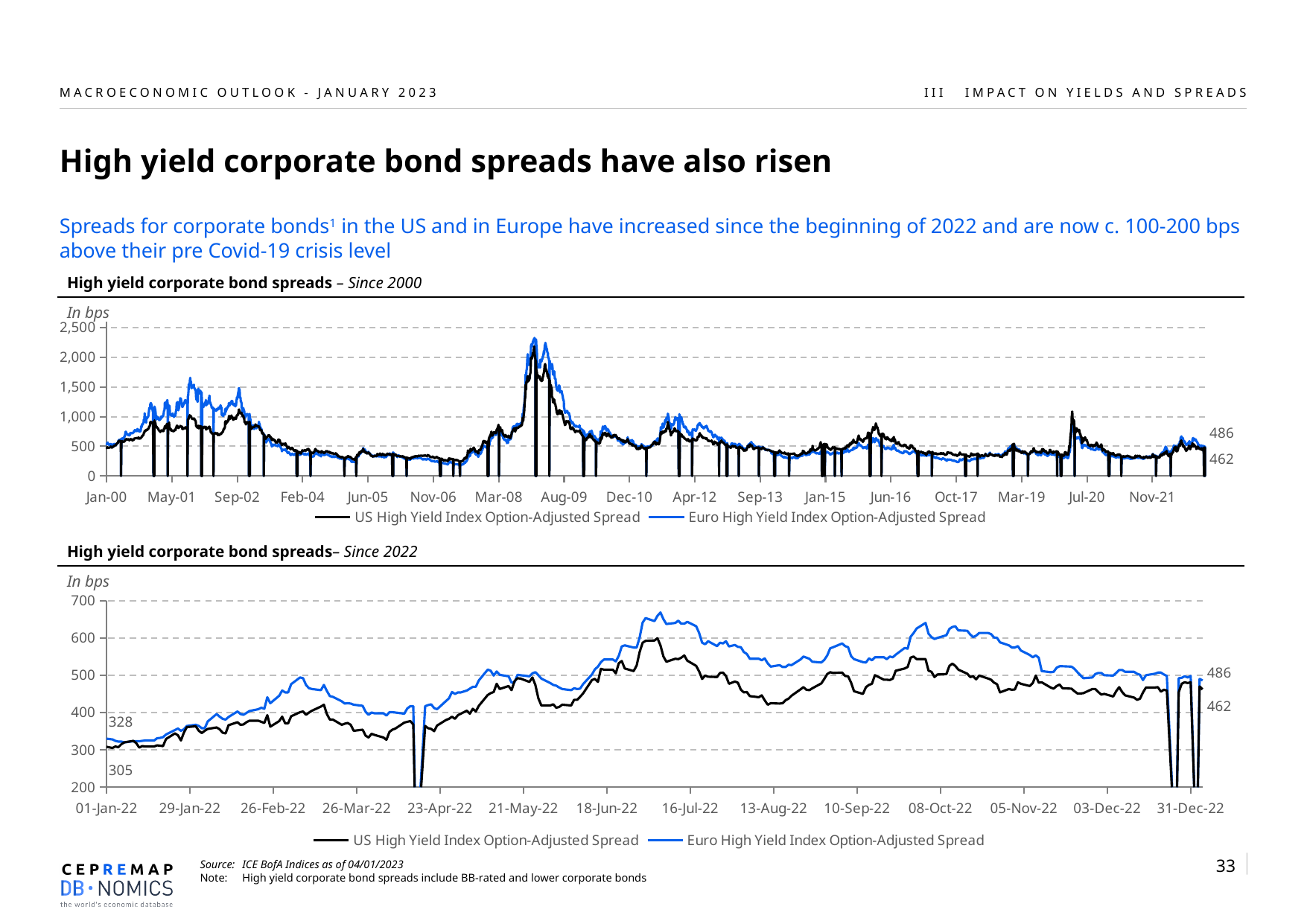
In the 'High yield corporate bond spreads – Since 2000' chart, what is the final value shown for the US High Yield Index Option-Adjusted Spread? 462 In the 'High yield corporate bond spreads – Since 2022' chart, which colour is used for the Euro High Yield Index Option-Adjusted Spread? Blue What kind of chart is the 'High yield corporate bond spreads – Since 2000' chart? Line chart In the 'High yield corporate bond spreads – Since 2022' chart, what is the final value of the US High Yield Index Option-Adjusted Spread? 462 In the 'High yield corporate bond spreads – Since 2022' chart, by how much did the Euro High Yield spread rise from its starting value to its final value? 158 In the 'High yield corporate bond spreads – Since 2022' chart, what is the starting value of the Euro High Yield Index Option-Adjusted Spread on 01-Jan-22? 328 In the 'High yield corporate bond spreads – Since 2000' chart, is the peak of the Euro High Yield spread around 2008-2009 greater or less than 2,000? greater How many series does the legend of the 'High yield corporate bond spreads – Since 2022' chart list? 2 In the 'High yield corporate bond spreads – Since 2022' chart, which series ends higher, the US or the Euro High Yield Index Option-Adjusted Spread? Euro High Yield Index Option-Adjusted Spread In the 'High yield corporate bond spreads – Since 2022' chart, what is the difference between the final Euro spread and the final US spread? 24 In the 'High yield corporate bond spreads – Since 2022' chart, what is the starting value of the US High Yield Index Option-Adjusted Spread on 01-Jan-22? 305 In the 'High yield corporate bond spreads – Since 2022' chart, what is the final value of the Euro High Yield Index Option-Adjusted Spread? 486